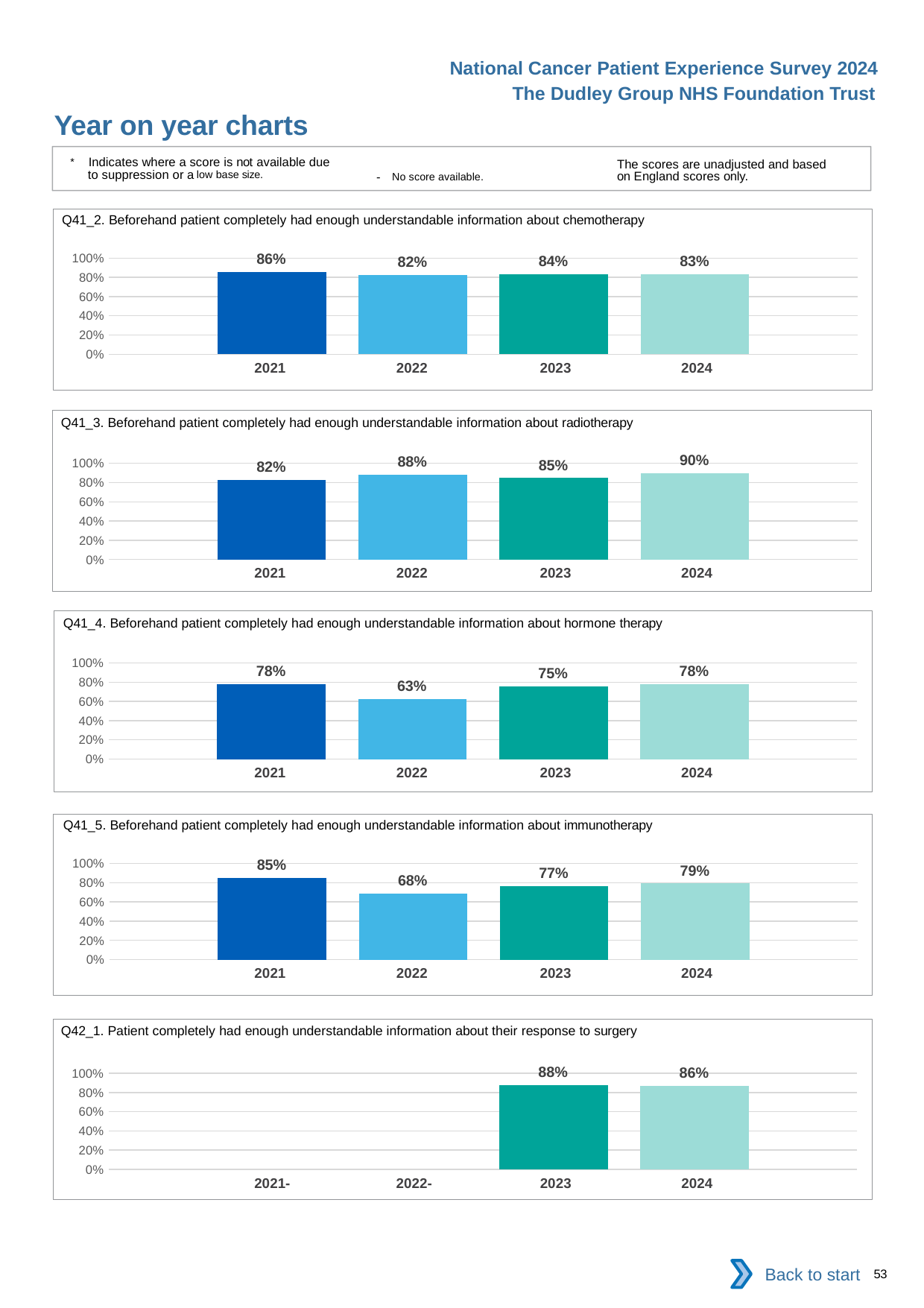
In the Q41_3 chart (radiotherapy), what is the value for 2022? 88% In the Q41_5 chart (immunotherapy), what is the difference between the 2021 and 2022 values? 17% In the Q41_2 chart (chemotherapy), how many years have a plotted bar? 4 What kind of chart is the Q41_4 chart (hormone therapy)? Bar chart How many charts are shown on the slide? 5 In the Q41_5 chart (immunotherapy), what is the value for 2024? 79% In the Q41_3 chart (radiotherapy), which year has the highest value? 2024 In the Q41_2 chart (chemotherapy), what is the difference between the 2021 and 2022 values? 4% In the Q41_2 chart (chemotherapy), what is the value for 2021? 86% In the Q41_4 chart (hormone therapy), which year has the lowest value? 2022 In the Q42_1 chart (response to surgery), how many years have a plotted bar? 2 In the Q42_1 chart (response to surgery), which is larger, the value for 2023 or 2024? 2023